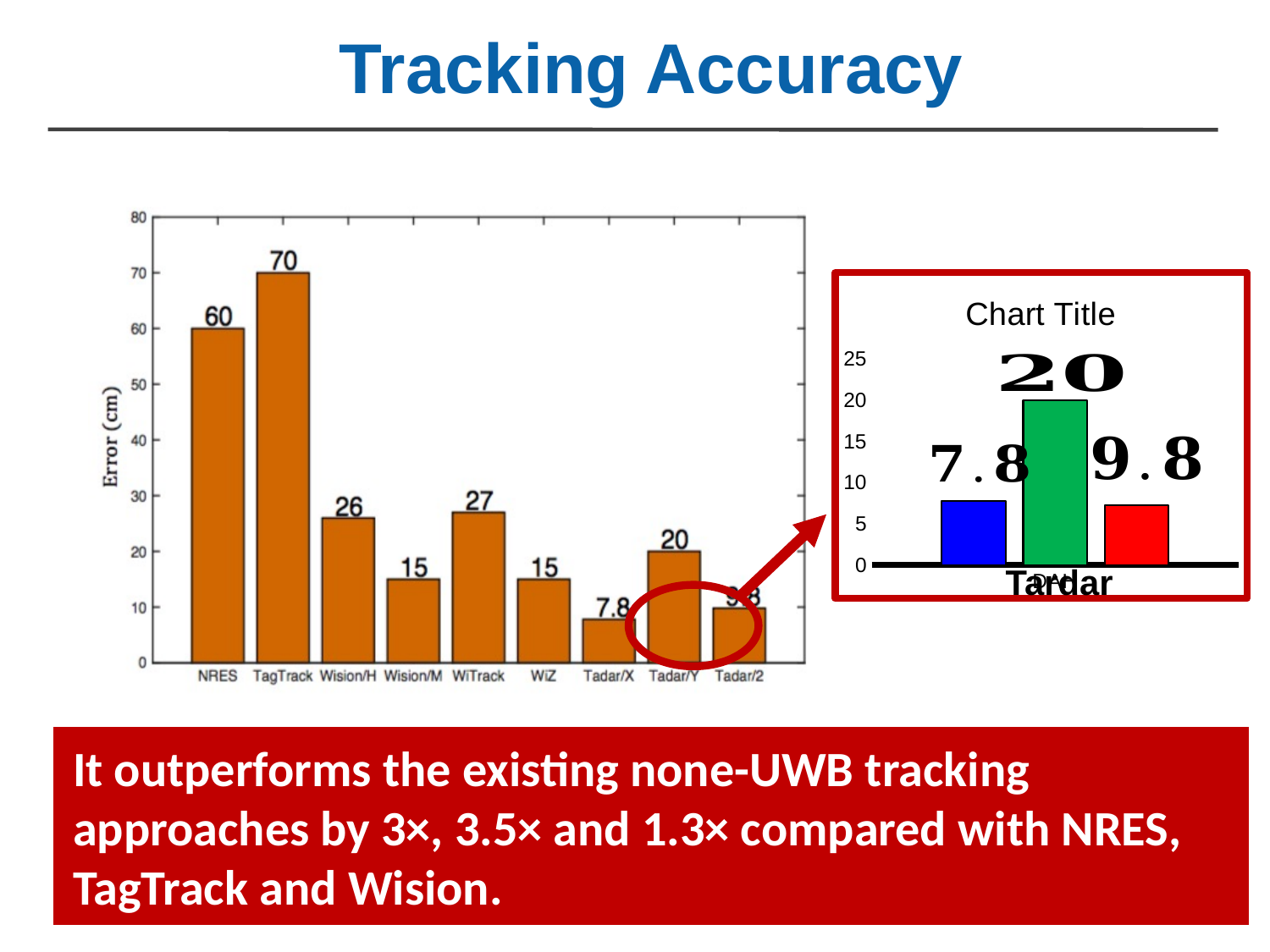
In the large bar chart on the left, how many categories are shown on the x axis? 9 What kind of chart is the large chart on the left? bar chart In the large bar chart on the left, which category has the highest error? TagTrack In the chart titled 'Chart Title' on the right, what is the value of the green bar? 20 In the large bar chart on the left, which category has the lowest error? Tadar/X In the large bar chart on the left, which has a larger error, WiTrack or Wision/H? WiTrack In the large bar chart on the left, what is the difference between the error for TagTrack and the error for NRES? 10 In the large bar chart on the left, what is the error for NRES? 60 In the large bar chart on the left, what is the error for Tadar/X? 7.8 In the chart titled 'Chart Title' on the right, how many bars are plotted? 3 In the large bar chart on the left, what is the error for TagTrack? 70 In the large bar chart on the left, what is the label of the y axis? Error (cm)